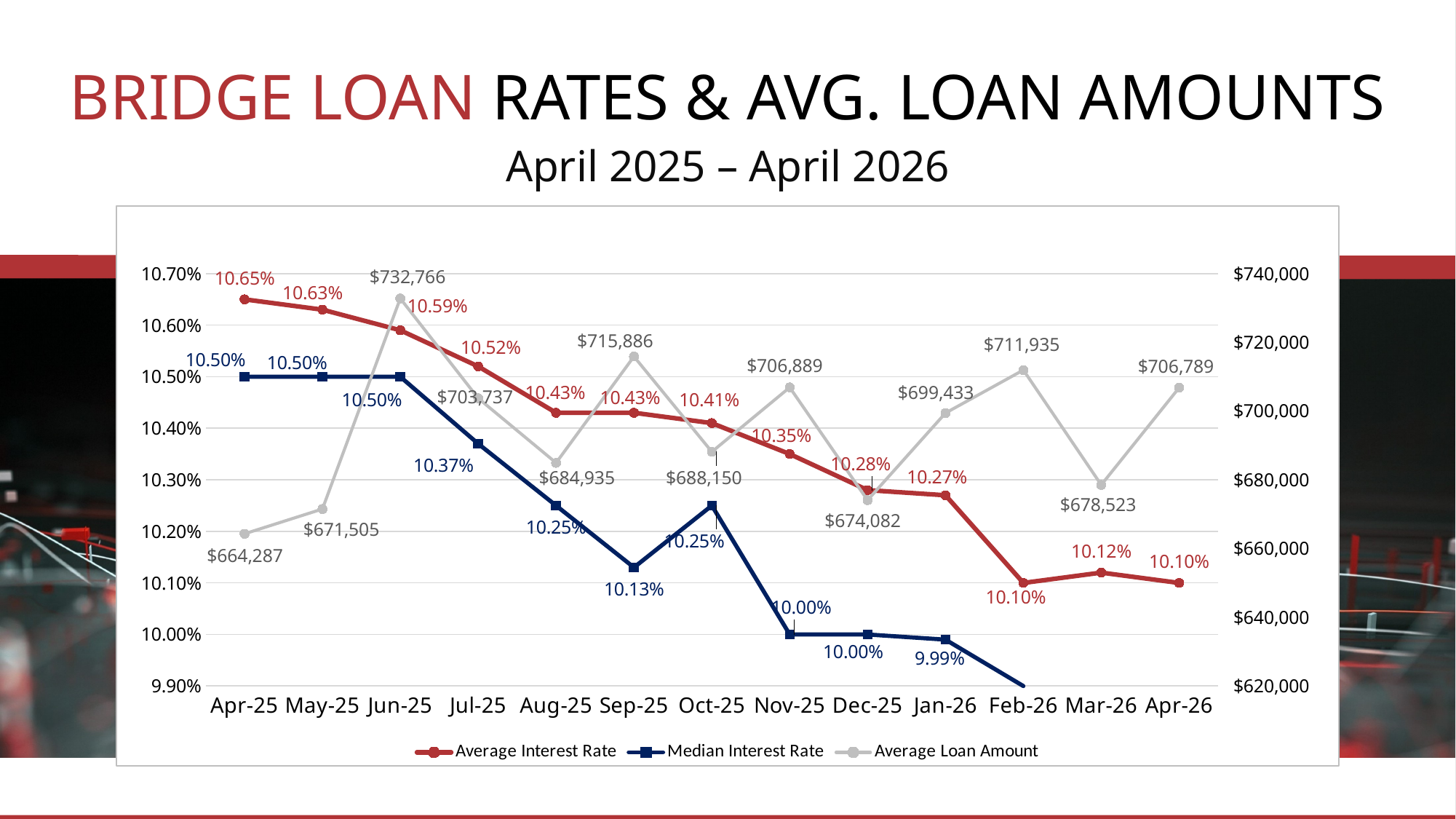
In which month is the Average Interest Rate highest? Apr-25 In which month is the Average Loan Amount highest? Jun-25 What is the Average Loan Amount for Jun-25? $732,766 What kind of chart is shown on the slide? Line chart How many months are plotted along the x axis? 13 Does the Average Interest Rate generally rise or fall from Apr-25 to Apr-26? Fall In which month is the Average Loan Amount lowest? Apr-25 What is the Average Interest Rate for Apr-25? 10.65% What is the Median Interest Rate for Jul-25? 10.37% Which month has the larger Average Loan Amount, Sep-25 or Nov-25? Sep-25 By how much did the Average Interest Rate fall from Apr-25 to Apr-26? 0.55 percentage points How many series does the legend list? 3